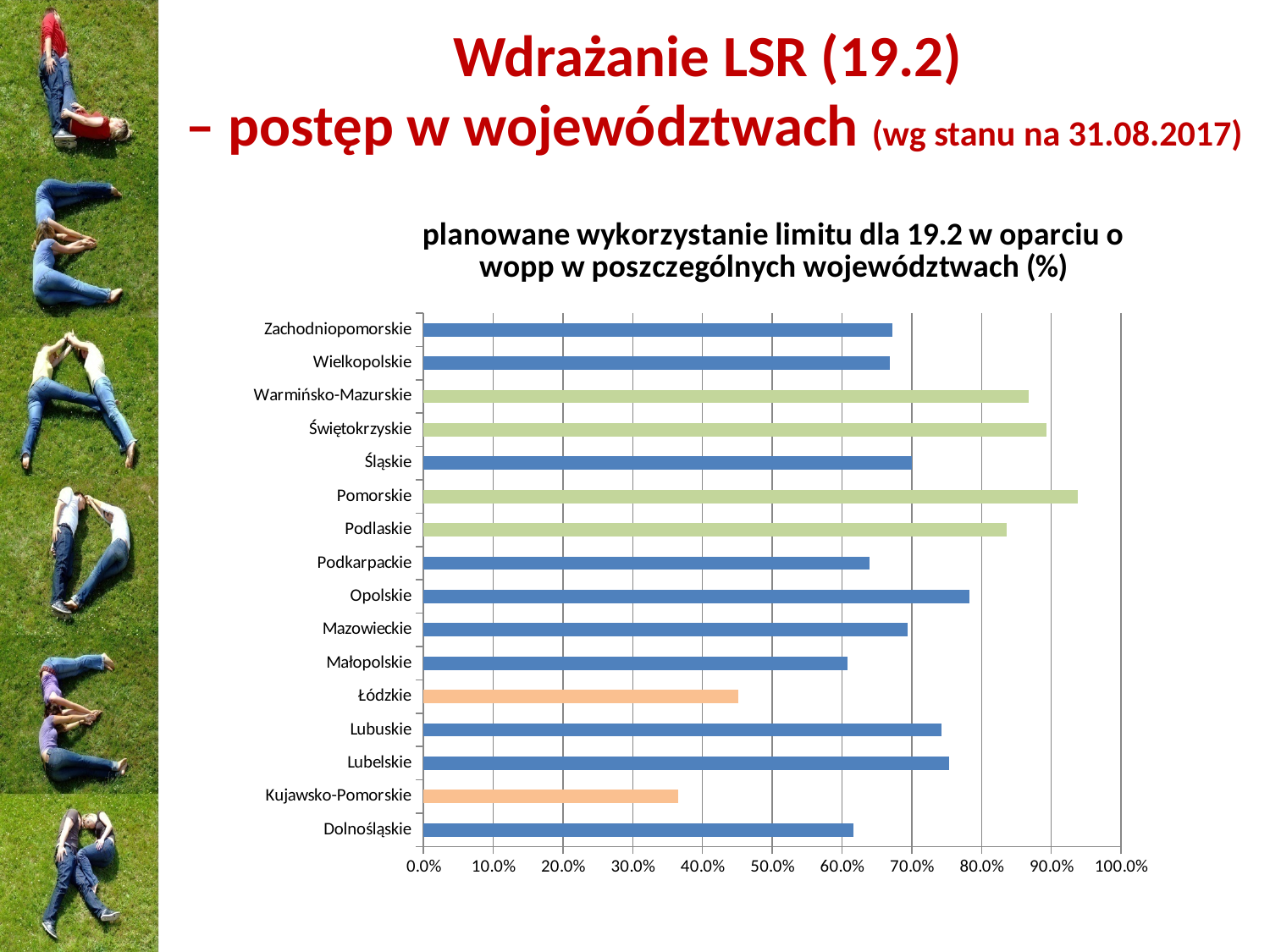
Is the value for Opolskie greater or less than 70.0%? greater How many voivodeships (categories) are plotted in the chart? 16 What kind of chart is shown on the slide? bar chart Which has a higher value, Opolskie or Podkarpackie? Opolskie Is the value for Pomorskie greater or less than 90.0%? greater What is the title of the chart? planowane wykorzystanie limitu dla 19.2 w oparciu o wopp w poszczególnych województwach (%) Which has a higher value, Podlaskie or Lubelskie? Podlaskie Which voivodeship has the highest planned use of the 19.2 limit? Pomorskie Is the value for Kujawsko-Pomorskie greater or less than 40.0%? less Which voivodeship has the lowest planned use of the 19.2 limit? Kujawsko-Pomorskie